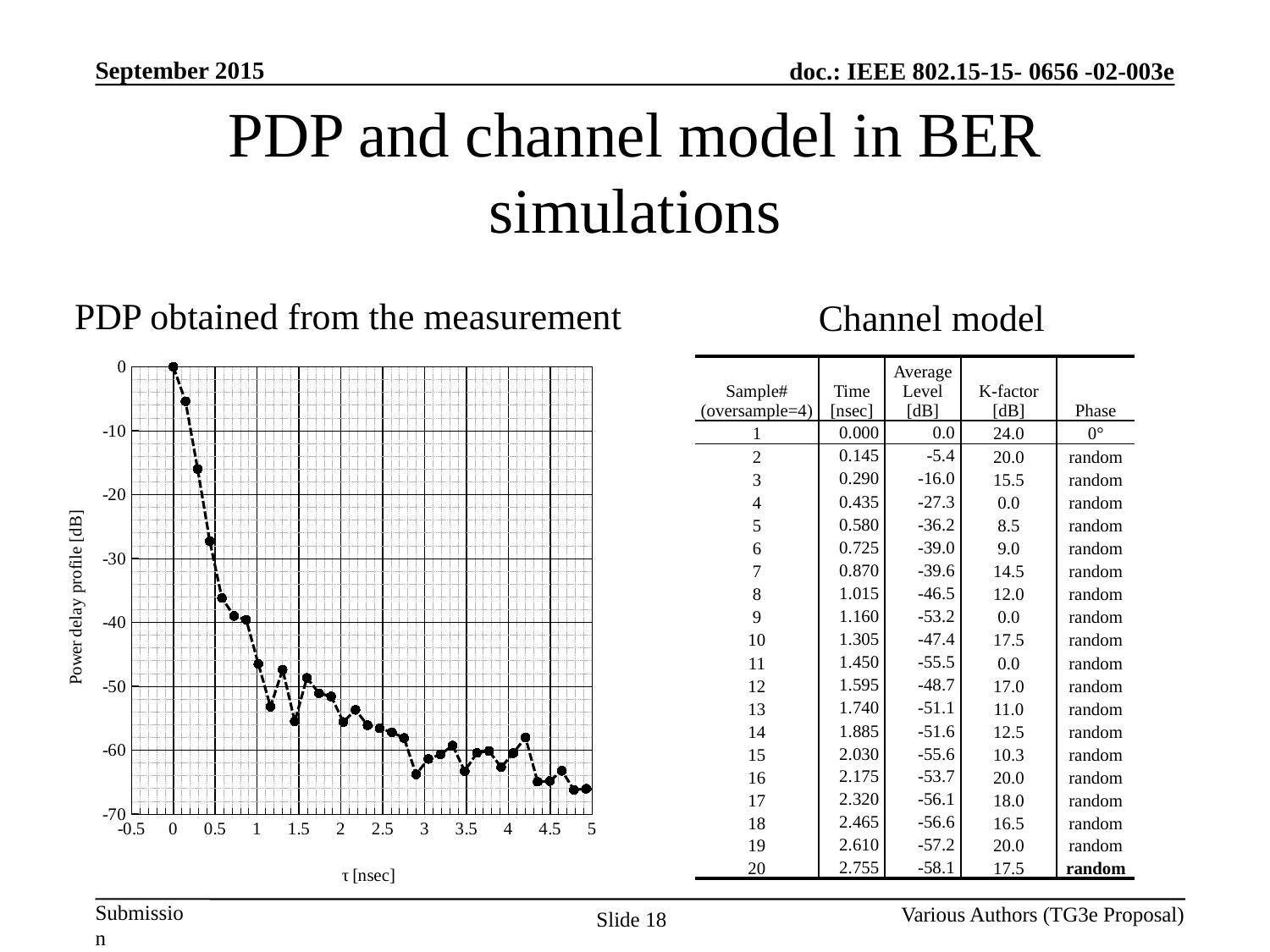
What is the power delay profile value at τ = 0 nsec? 0 What is the label of the y axis of the chart? Power delay profile [dB] Is the value of the first point after τ = 0 nsec greater or less than -10? greater Is the value for τ = 1 nsec greater or less than -40? less At which τ value does the power delay profile reach its highest value? 0 nsec Is the value for τ = 4.5 nsec greater or less than -60? less Which has the larger power delay profile value, τ = 0.5 nsec or τ = 1 nsec? τ = 0.5 nsec What is the label of the x axis of the chart? τ [nsec] What kind of chart is shown on the slide? line chart Do the power delay profile values generally rise or fall as τ increases? fall